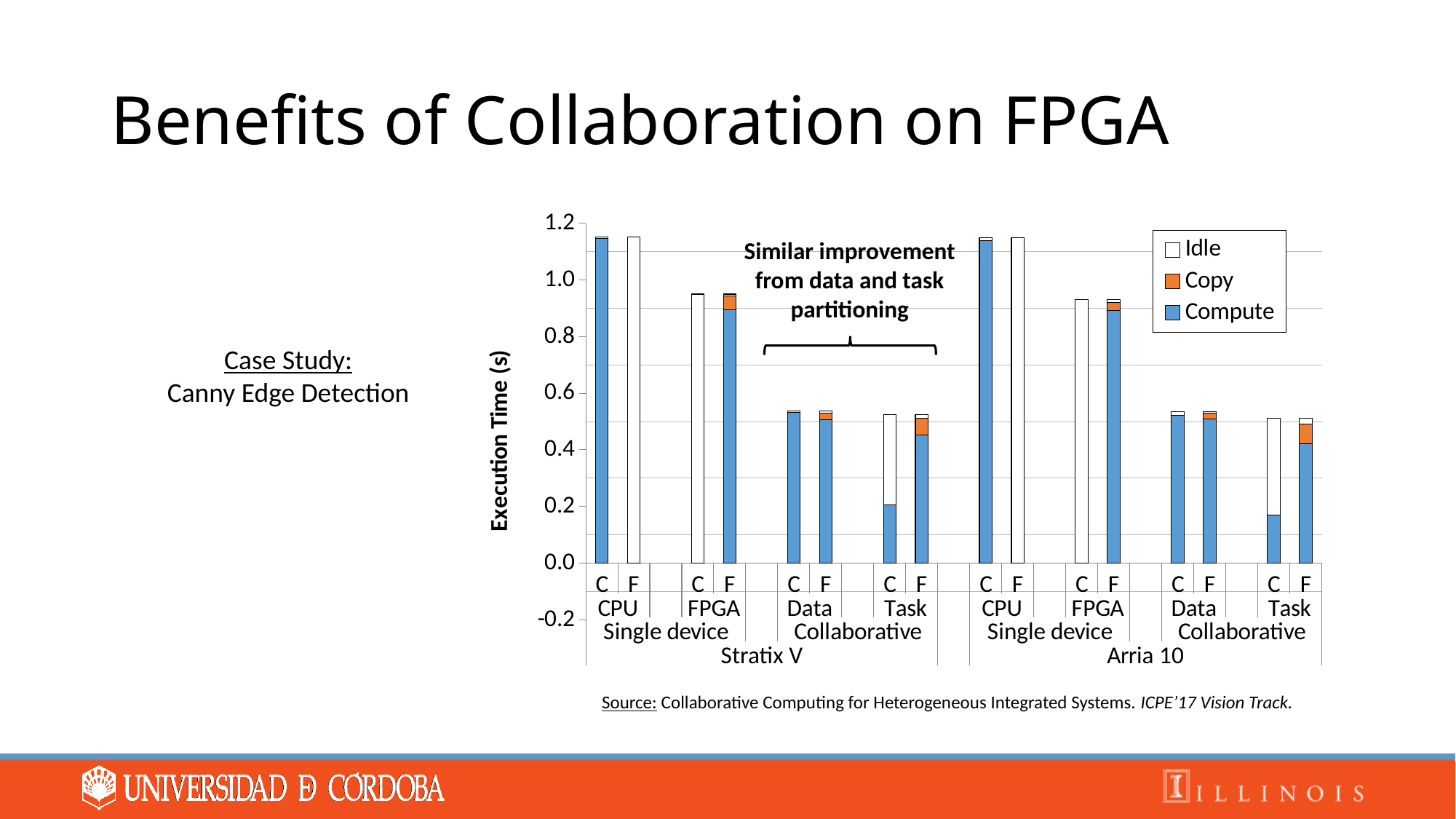
What is the label of the vertical axis of the chart? Execution Time (s) What kind of chart is shown on the slide? stacked bar chart Is the total execution time for the Arria 10 Single device FPGA 'F' bar greater or less than 0.8? greater How many bars are plotted in the Stratix V group of the chart? 8 In the Arria 10 group, which has the larger Compute portion: the Single device FPGA 'F' bar or the Collaborative Data 'F' bar? Single device FPGA 'F' Is the Compute portion of the Arria 10 Collaborative Task 'C' bar greater or less than 0.2? less How many series does the chart legend list? 3 What are the three series named in the chart legend? Idle, Copy, Compute How many platforms (top-level groups) are shown along the x axis of the chart? 2 Is the total execution time for the Stratix V Collaborative Data 'C' bar greater or less than 0.6? less In the Stratix V group, which has the larger total execution time: the Single device CPU 'C' bar or the Collaborative Data 'C' bar? Single device CPU 'C'